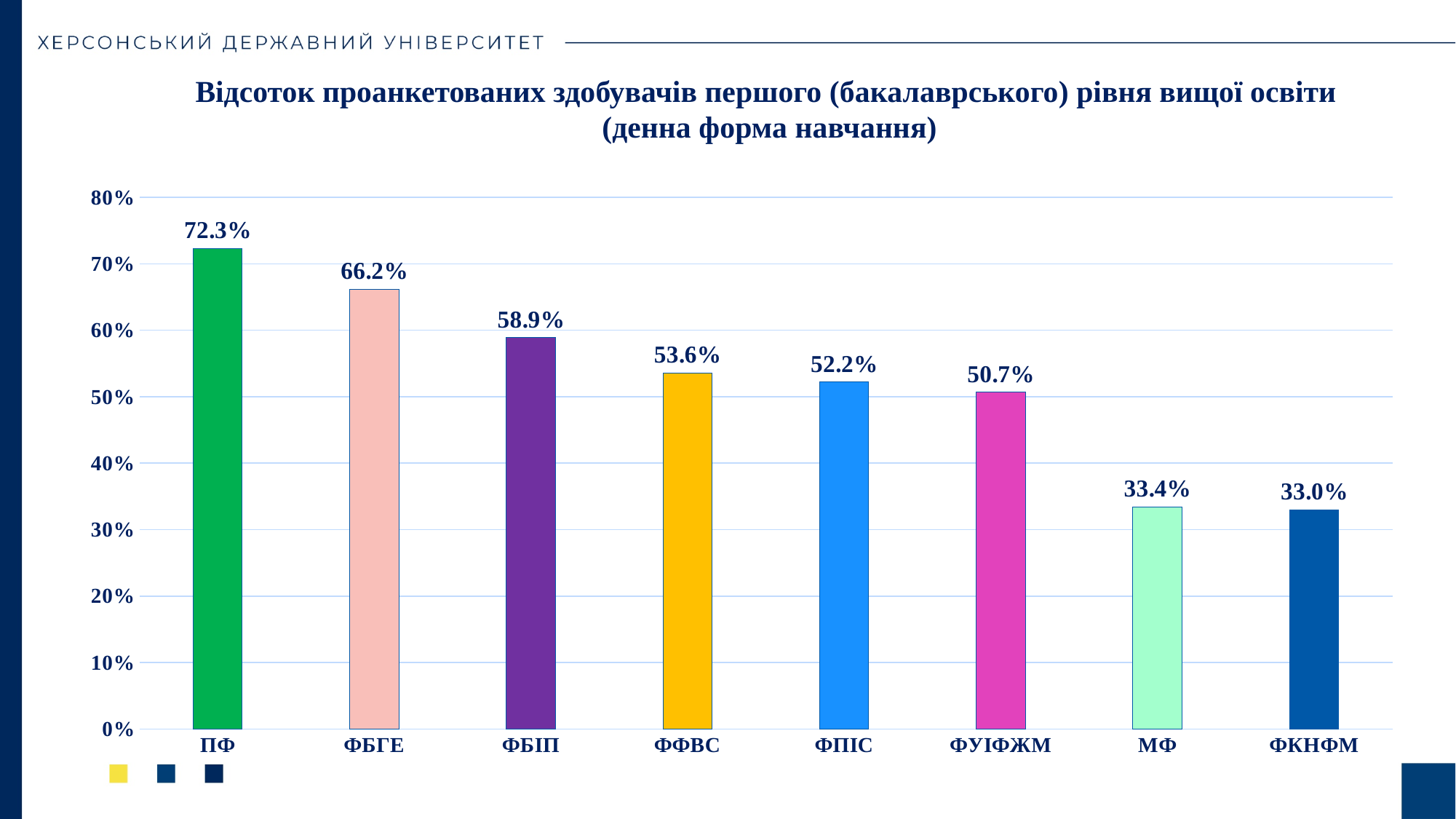
Which category has the highest value? ПФ What is the value for ФУІФЖМ? 50.7% What is the value for ФКНФМ? 33.0% What is the value for ПФ? 72.3% Do the values rise or fall from left to right along the x axis? Fall What is the value for ФБГЕ? 66.2% Which is larger, the value for ФПІС or the value for ФУІФЖМ? ФПІС How many categories are shown on the x axis? 8 What is the difference between the values for ФБІП and ФФВС? 5.3% Which category has the lowest value? ФКНФМ What is the difference between the values for ПФ and ФБГЕ? 6.1% What kind of chart is shown on the slide? Bar chart